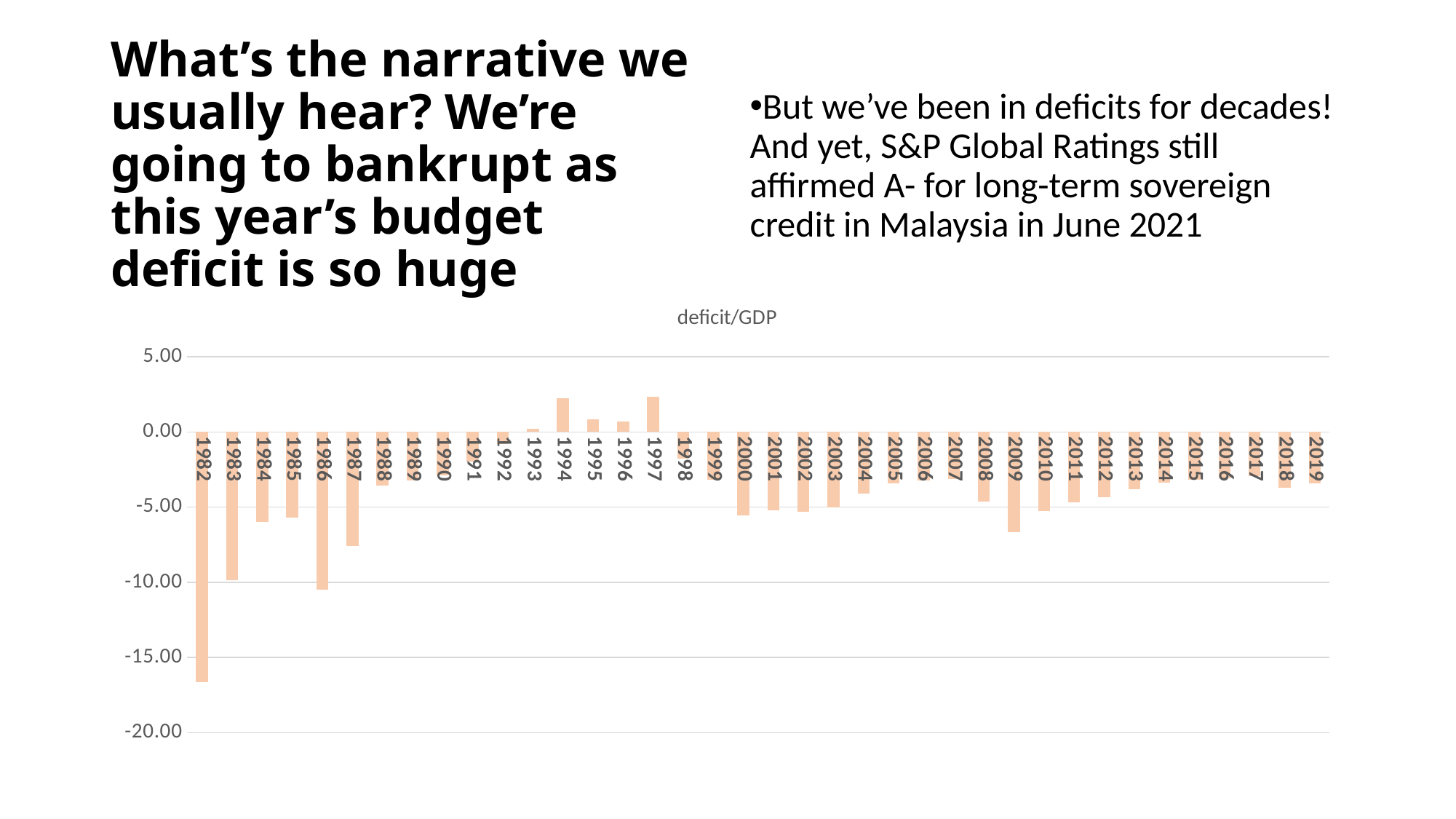
Which year has the lowest value in the chart? 1982 Is the value for 2009 greater or less than -5.00? less Is the value for 2007 greater or less than -5.00? greater Is the value for 1987 greater or less than -5.00? less What is the title of the chart? deficit/GDP From 2009 to 2017, do the values generally rise or fall? rise How many years are plotted on the x axis of the chart? 38 What kind of chart is shown on the slide? bar chart Which of 1982 and 1986 has the lower value? 1982